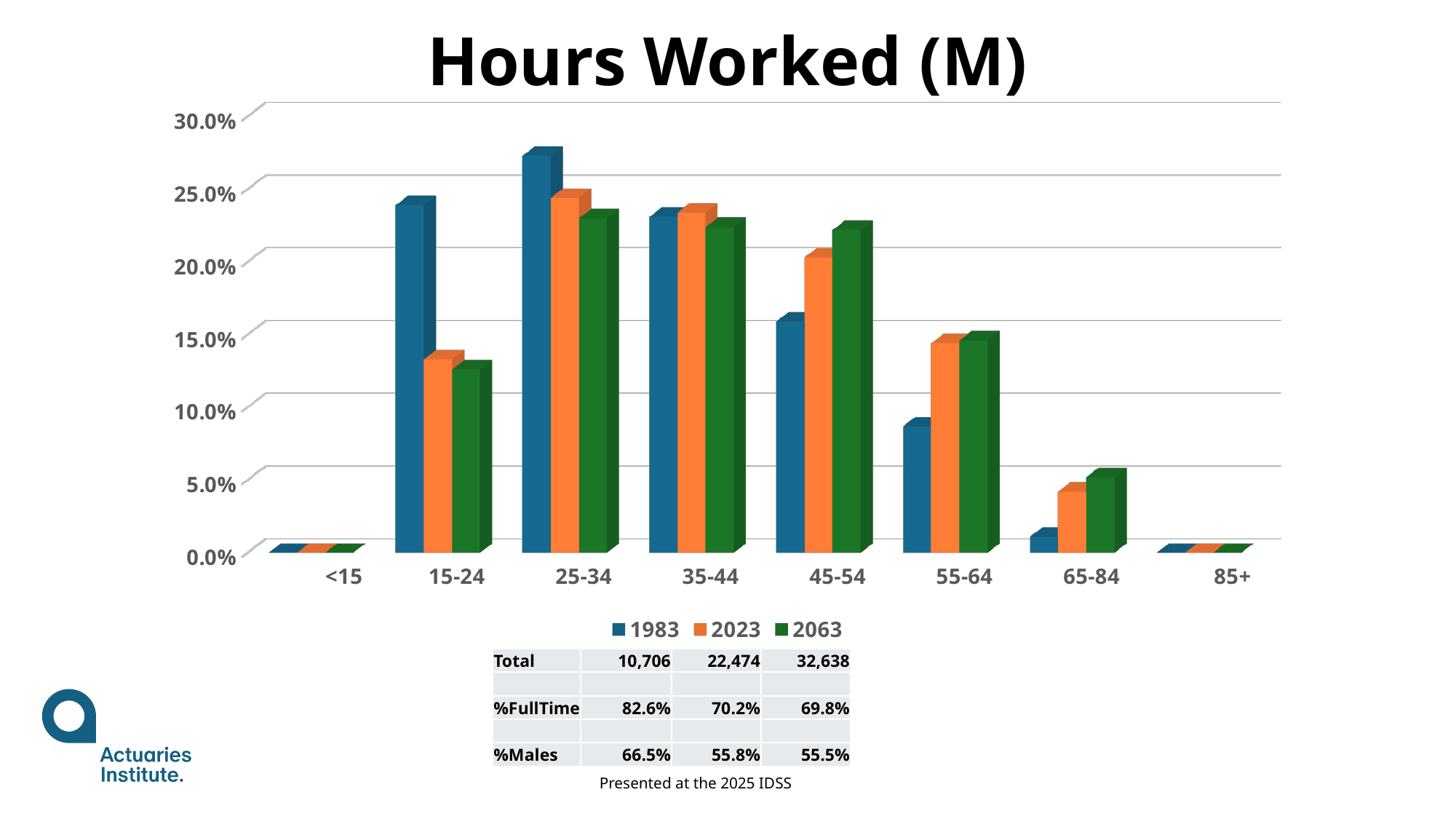
Is the 1983 value for 15-24 greater or less than 20.0%? greater Is the 2023 value for 15-24 greater or less than 15.0%? less Is the 1983 value for 25-34 greater or less than 25.0%? greater For the 45-54 category, which series has the larger value, 1983 or 2023? 2023 How many age categories are shown on the x axis? 8 How many series does the legend list? 3 For the 15-24 category, which series has the larger value, 1983 or 2023? 1983 What is the title of the chart? Hours Worked (M) Which age category has the highest value for the 1983 series? 25-34 What kind of chart is shown on the slide? bar chart For the 55-64 category, which series has the larger value, 1983 or 2063? 2063